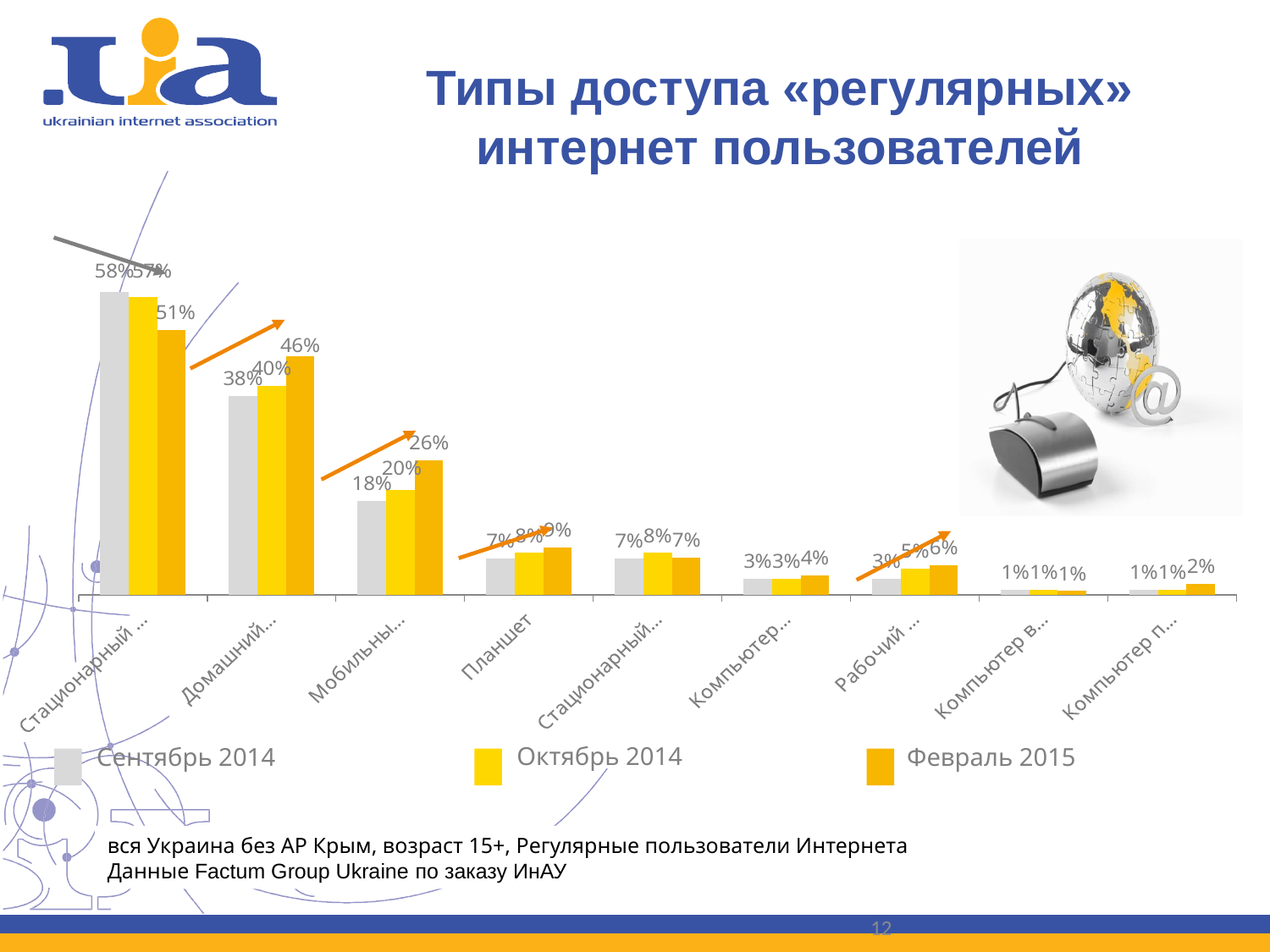
What kind of chart is shown on the slide? bar chart What is the value for Планшет in Сентябрь 2014? 7% What is the Февраль 2015 value for the first (leftmost) category? 51% How many categories are shown along the x axis of the chart? 9 For the first (leftmost) category, what is the difference between the Сентябрь 2014 value and the Февраль 2015 value? 7 percentage points What is the Февраль 2015 value for the second category from the left? 46% What is the value for Планшет in Февраль 2015? 9% For the second category from the left, do the values rise or fall from Сентябрь 2014 to Февраль 2015? rise How many series does the chart legend list? 3 For the third category from the left, which is larger: the Сентябрь 2014 value or the Февраль 2015 value? Февраль 2015 What are the three legend entries of the chart? Сентябрь 2014, Октябрь 2014, Февраль 2015 For Планшет, which period has the highest value? Февраль 2015